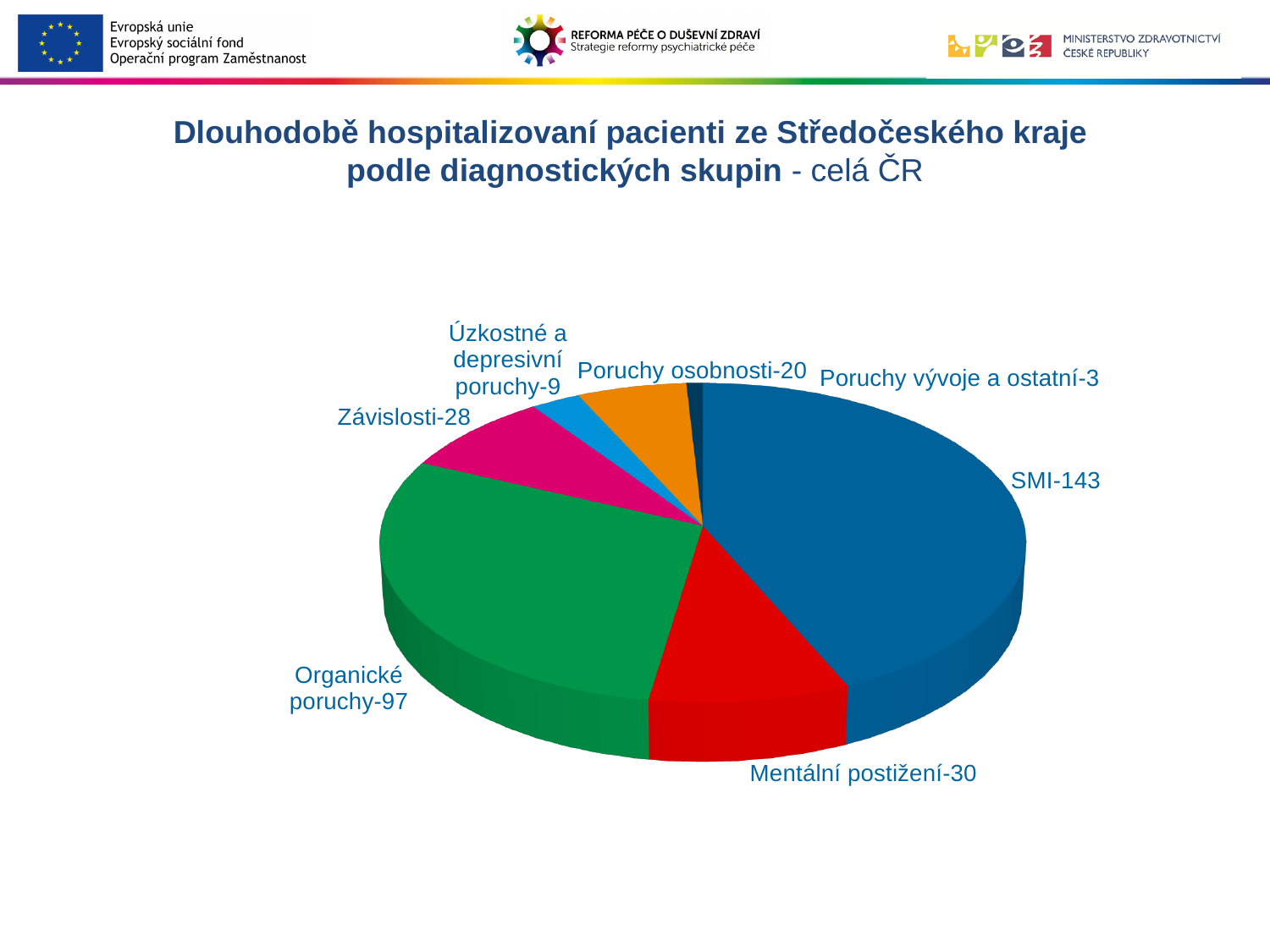
What kind of chart is shown on the slide? pie chart Which is larger, the value for Závislosti or the value for Poruchy osobnosti? Závislosti Which category has the smallest slice? Poruchy vývoje a ostatní What is the value for Mentální postižení? 30 How many categories (slices) does the pie chart have? 7 What is the difference between the values for SMI and Organické poruchy? 46 What is the value for Organické poruchy? 97 Which category has the largest slice? SMI What colour is the SMI slice? blue What is the value for Úzkostné a depresivní poruchy? 9 What is the total of all the values shown in the pie chart? 330 What is the value for SMI? 143